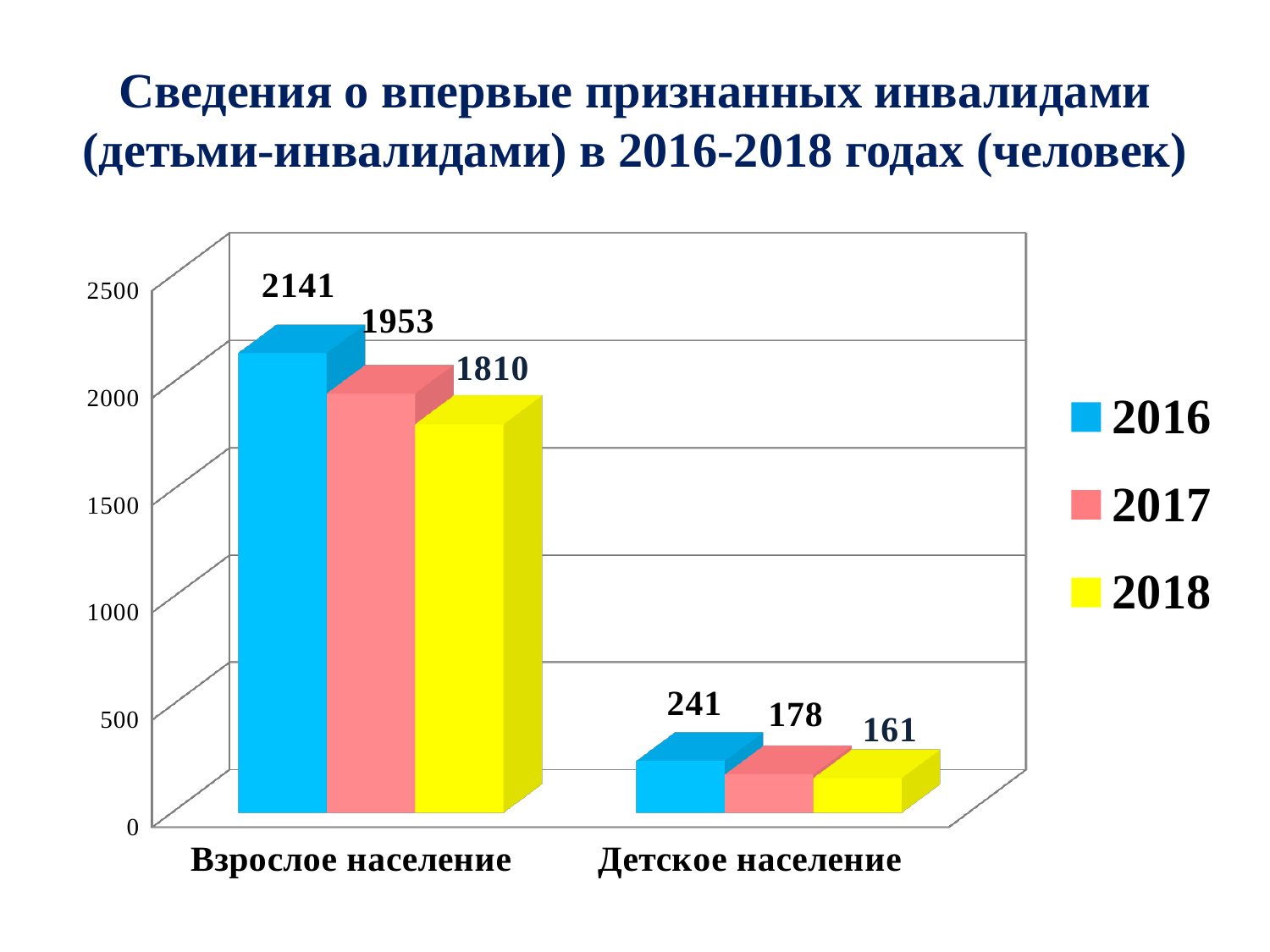
Which year has the highest value for Взрослое население? 2016 What kind of chart is shown on the slide? Bar chart What is the value for Детское население in 2018? 161 What is the value for Взрослое население in 2017? 1953 What is the value for Взрослое население in 2016? 2141 Which is larger: the 2017 value for Взрослое население or the 2018 value for Взрослое население? 2017 What is the difference between the 2016 and 2017 values for Детское население? 63 How many categories are shown on the x axis? 2 How many series does the legend list? 3 What is the difference between the 2016 and 2018 values for Взрослое население? 331 Which year has the lowest value for Детское население? 2018 What is the value for Детское население in 2017? 178